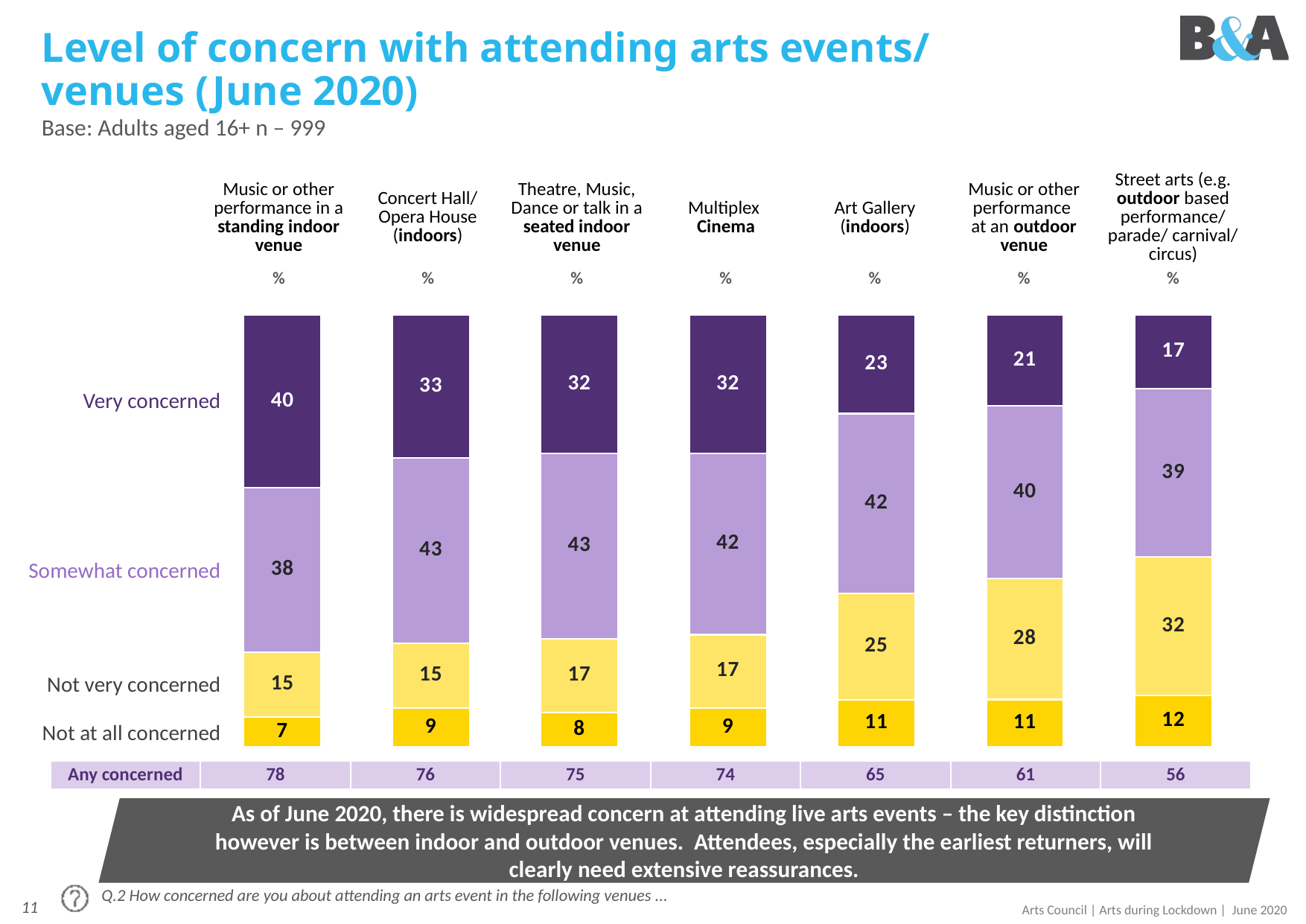
What type of chart is shown on the slide? Stacked bar chart What is the difference between the 'Very concerned' values for Multiplex Cinema and Street arts? 15 What is the 'Not at all concerned' value for Street arts? 12 What percentage of adults are very concerned about attending music or other performance in a standing indoor venue? 40 How many concern levels (series) are shown in the stacked bars? 4 Which venue has the highest 'Very concerned' value? Music or other performance in a standing indoor venue How many venue categories are shown in the chart? 7 Which venue has the lowest 'Very concerned' value? Street arts What is the 'Any concerned' value for Music or other performance at an outdoor venue? 61 What is the 'Somewhat concerned' value for Art Gallery (indoors)? 42 What is the combined 'Very concerned' and 'Somewhat concerned' total for Multiplex Cinema? 74 Is the 'Not very concerned' value larger for Street arts or for Concert Hall/Opera House (indoors)? Street arts